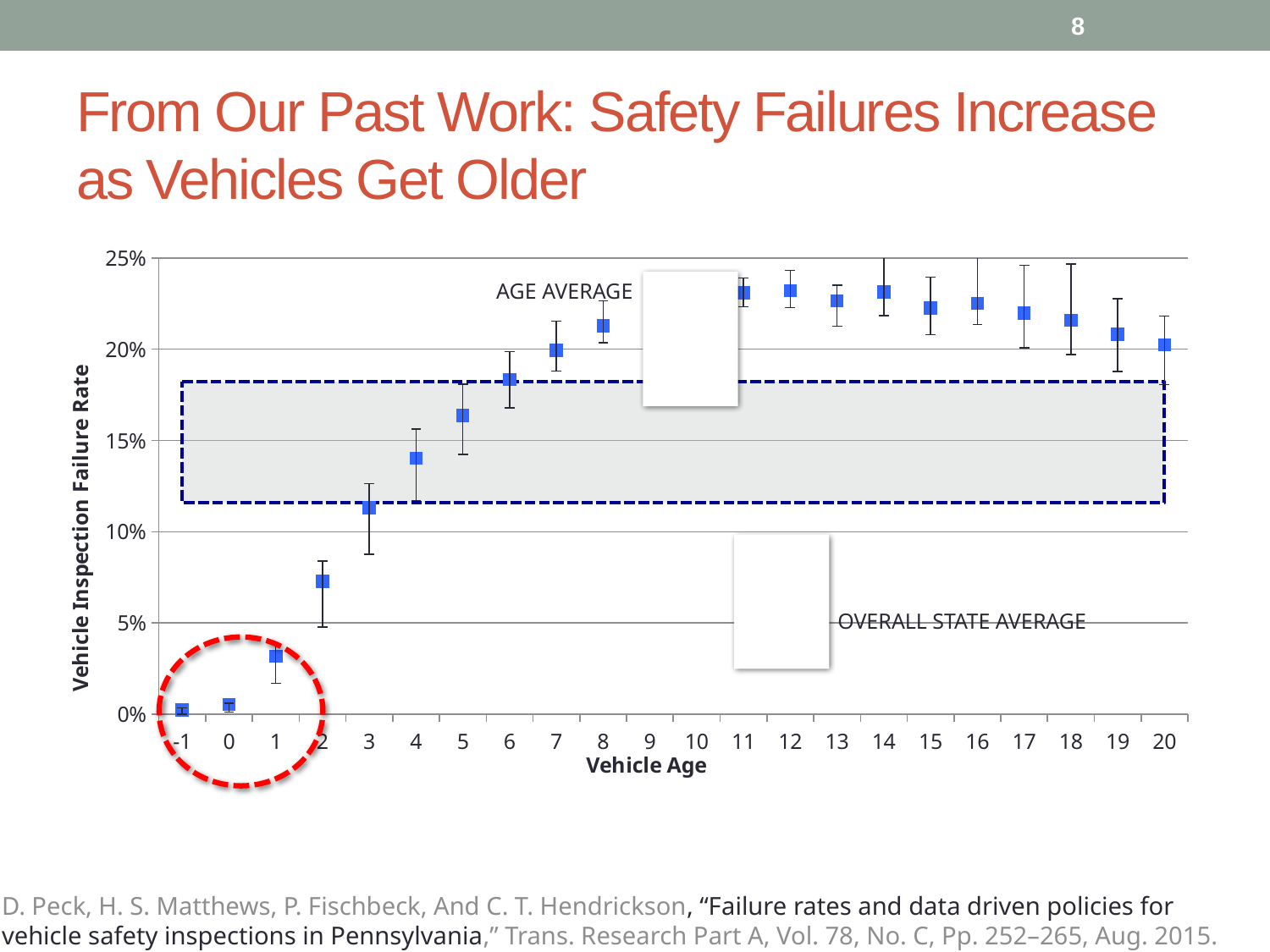
Is the failure rate for vehicle age 2 greater or less than 10%? less Which has the higher failure rate, vehicle age 2 or vehicle age 5? vehicle age 5 What is the title of the x axis of the chart? Vehicle Age Is the failure rate for vehicle age 3 greater or less than 10%? greater Is the failure rate for vehicle age 12 greater or less than 20%? greater How many vehicle age values are labeled on the x axis? 22 Does the failure rate rise or fall as vehicle age increases from -1 to 8? rise What is the title of the y axis of the chart? Vehicle Inspection Failure Rate What kind of chart is shown on the slide? scatter chart